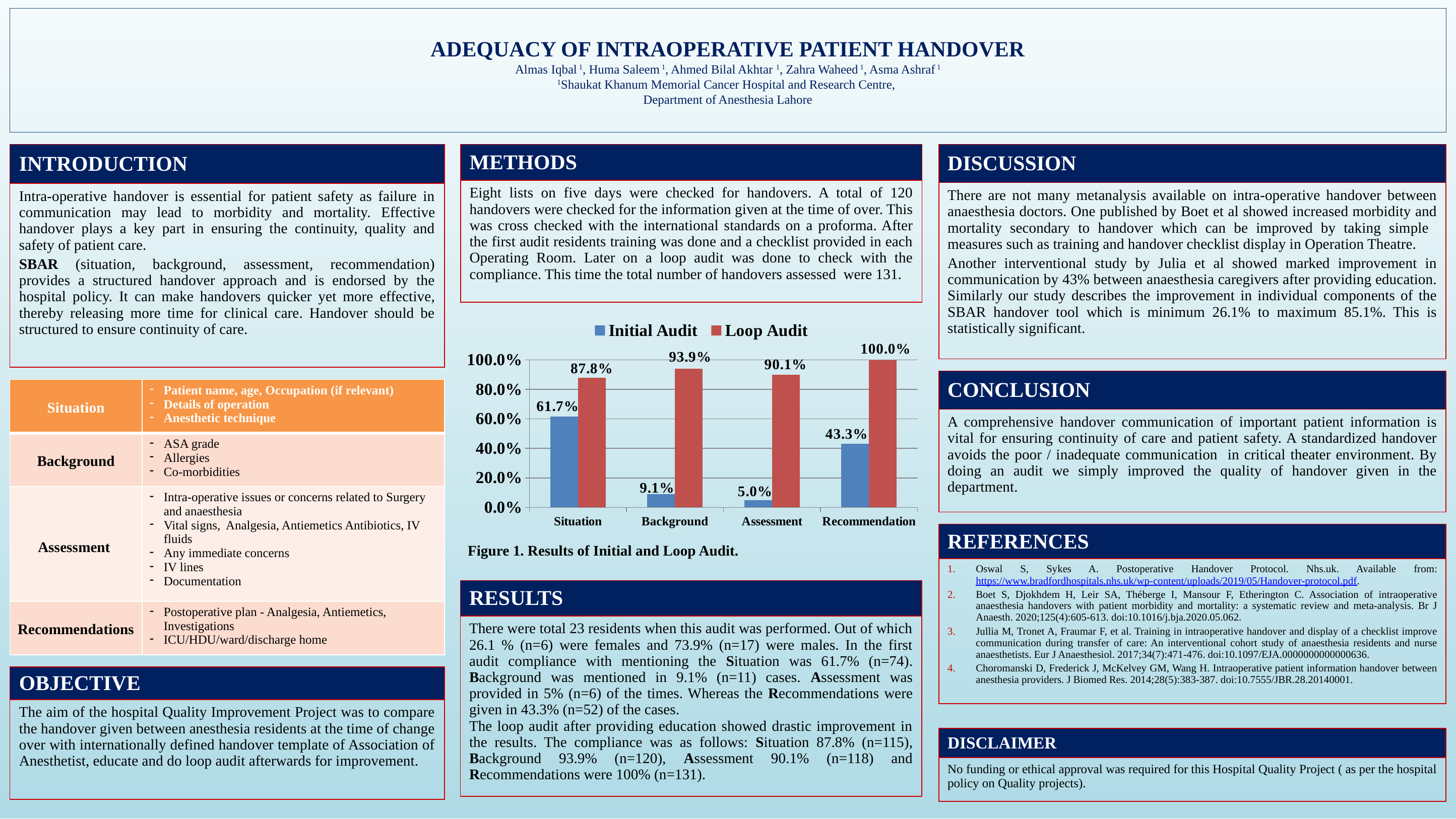
Which category has the lowest Initial Audit value? Assessment How many categories are shown on the x axis of the chart? 4 What is the difference between the Loop Audit and Initial Audit values for Background? 84.8% What is the Initial Audit value for Assessment? 5.0% Which category has the highest Loop Audit value? Recommendation What is the Initial Audit value for Situation? 61.7% What is the caption of the chart? Figure 1. Results of Initial and Loop Audit. Which is larger, the Initial Audit value for Situation or the Initial Audit value for Recommendation? Situation What is the Loop Audit value for Recommendation? 100.0% What kind of chart is shown on the slide? Bar chart How many series does the chart legend list? 2 What is the Loop Audit value for Background? 93.9%